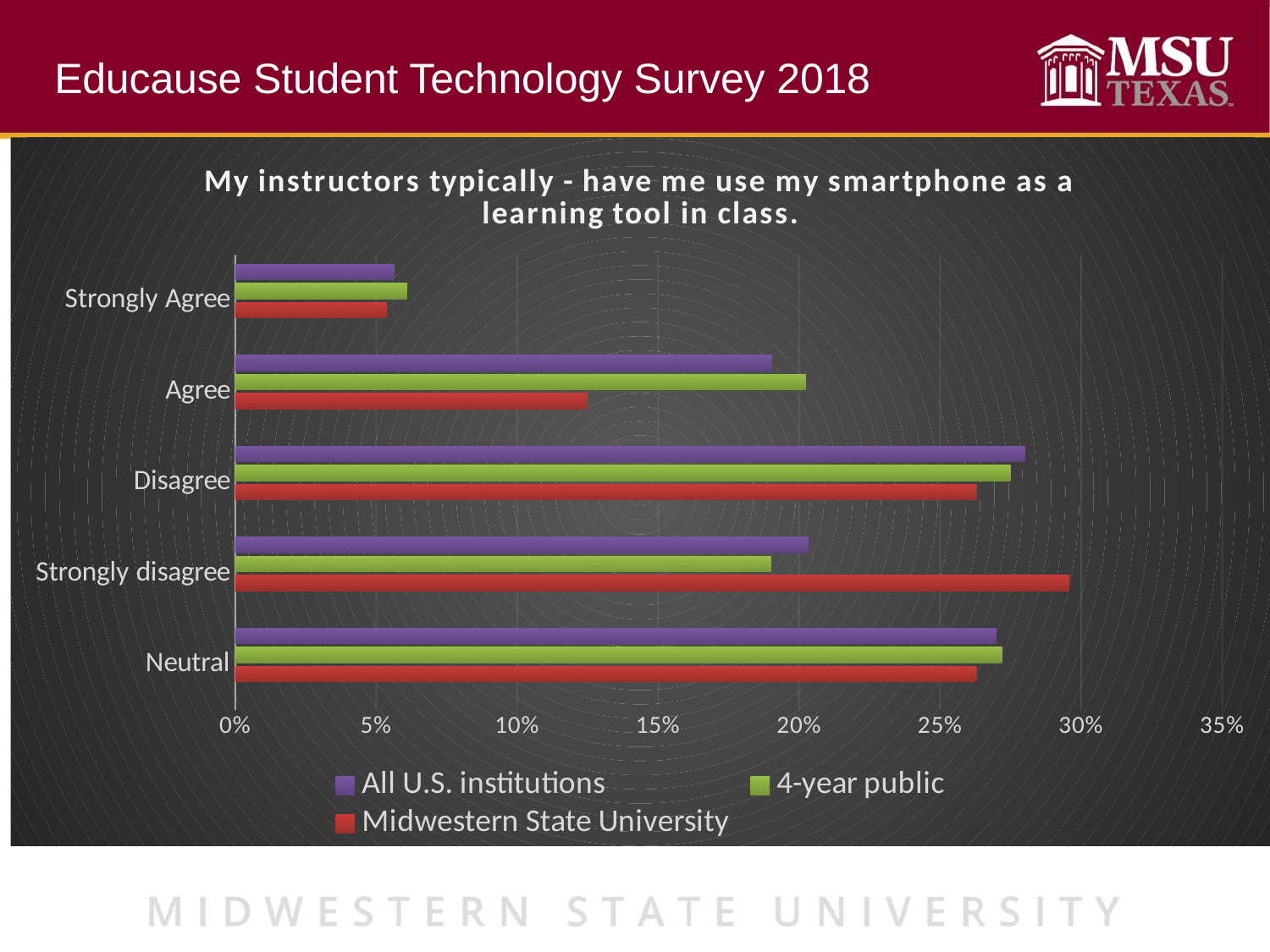
Which series is shown in red in the legend? Midwestern State University Is the Midwestern State University value for Strongly disagree greater or less than 25%? greater For Agree, which is larger: the 4-year public value or the Midwestern State University value? 4-year public How many series does the legend list? 3 Is the All U.S. institutions value for Disagree greater or less than 25%? greater For Midwestern State University, which response category has the lowest value? Strongly Agree What kind of chart is shown on the slide? bar chart For Strongly disagree, which is larger: the Midwestern State University value or the 4-year public value? Midwestern State University What is the title of the chart? My instructors typically - have me use my smartphone as a learning tool in class. Is the Midwestern State University value for Agree greater or less than 15%? less How many response categories are shown on the chart? 5 For Midwestern State University, which response category has the highest value? Strongly disagree